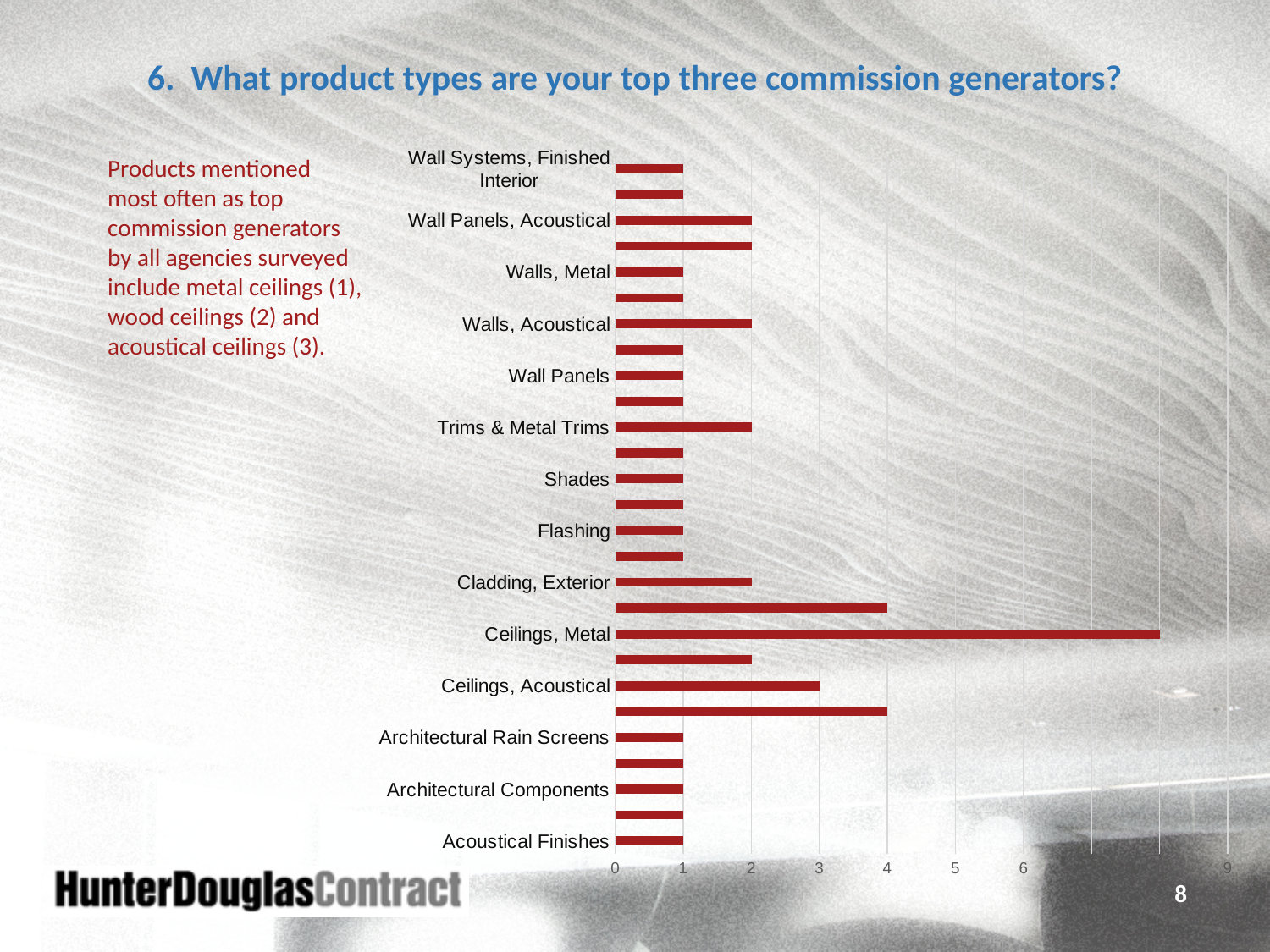
What is the value for Ceilings, Acoustical? 3 What is the value for Wall Panels, Acoustical? 2 Which product type has the longest bar in the chart? Ceilings, Metal What colour are the bars in the chart? red What is the value for Cladding, Exterior? 2 What is the value for Walls, Metal? 1 What is the title of the slide containing the chart? 6. What product types are your top three commission generators? What type of chart is shown on the slide? bar chart Which is larger, the value for Ceilings, Acoustical or the value for Cladding, Exterior? Ceilings, Acoustical What is the difference between the value for Ceilings, Acoustical and the value for Walls, Metal? 2 Is the value for Ceilings, Metal greater or less than 6? greater What is the value for Acoustical Finishes? 1